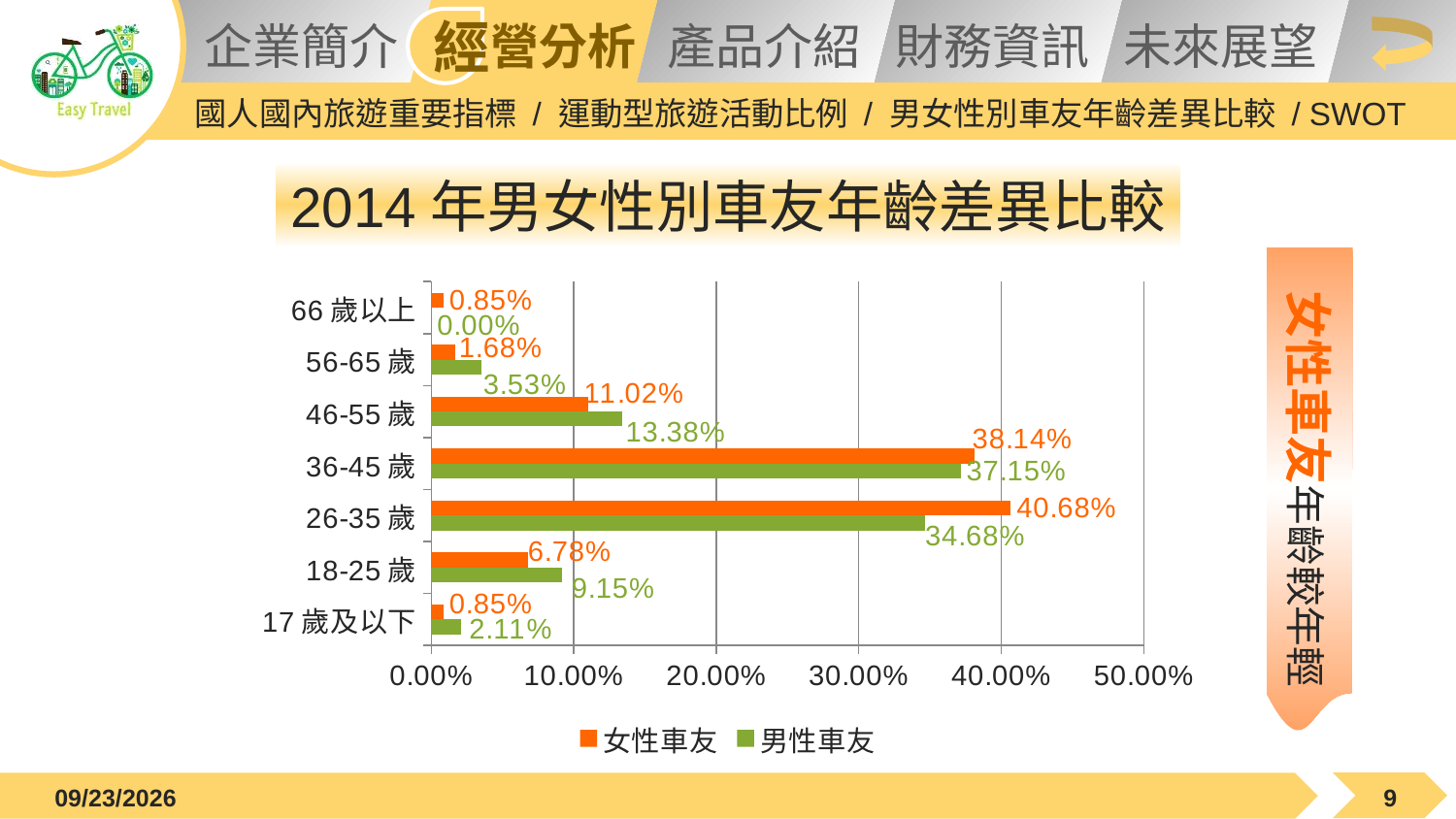
Which age category has the highest value for 男性車友? 36-45 歲 How many age categories are shown on the chart? 7 What is the difference between 女性車友 and 男性車友 in the 26-35 歲 category? 6.00% What kind of chart is shown on the slide? Bar chart What is the value for 男性車友 in the 66 歲以上 category? 0.00% In the 18-25 歲 category, which series has the larger value, 女性車友 or 男性車友? 男性車友 How many series does the legend list? 2 What is the title of the chart? 2014 年男女性別車友年齡差異比較 Which age category has the lowest value for 男性車友? 66 歲以上 What is the value for 男性車友 in the 46-55 歲 category? 13.38% Which age category has the highest value for 女性車友? 26-35 歲 What is the value for 女性車友 in the 26-35 歲 category? 40.68%